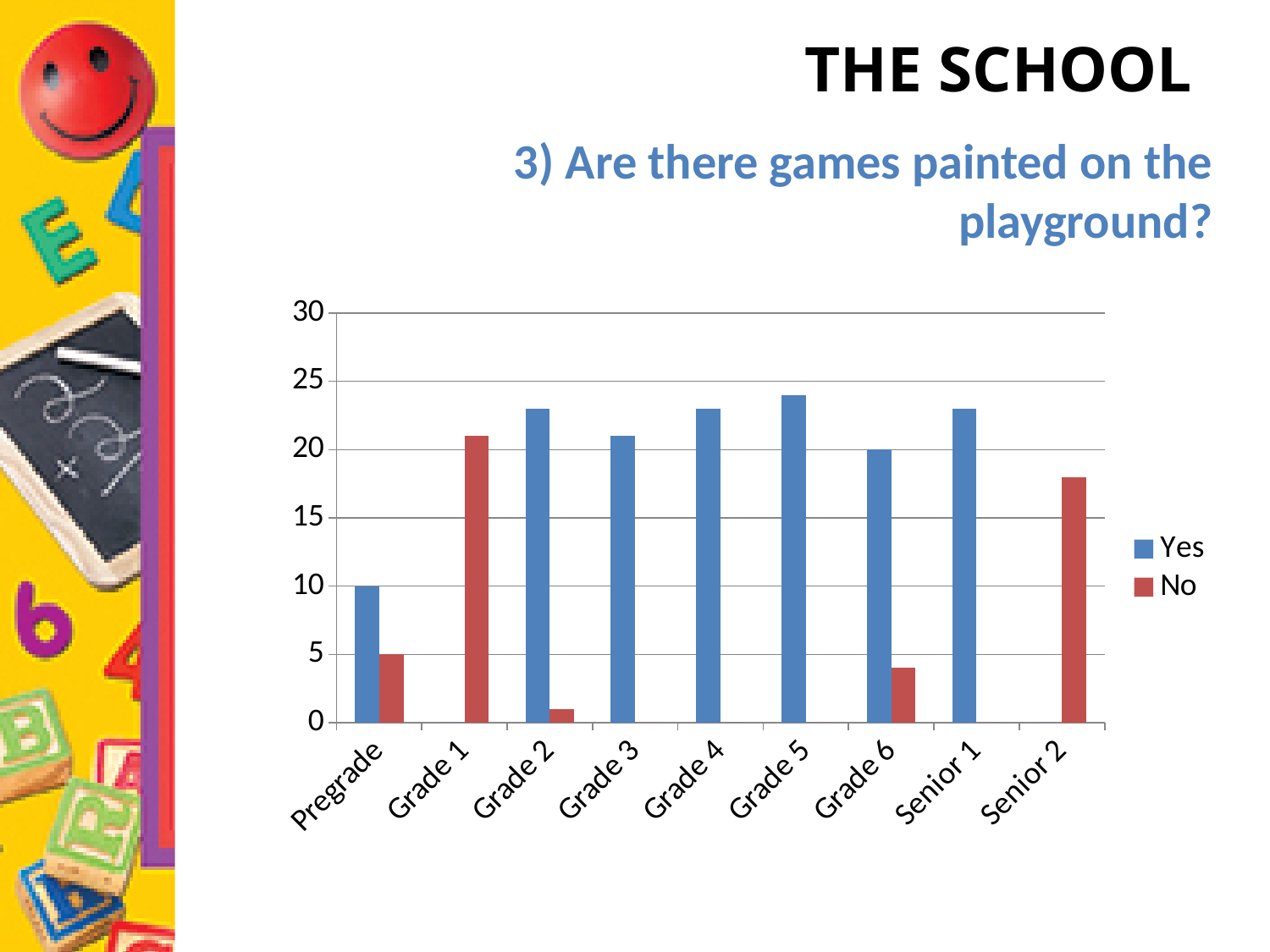
What is the value of the Yes bar for Grade 6? 20 For Pregrade, which is larger, the Yes bar or the No bar? Yes What is the value of the Yes bar for Pregrade? 10 Which category has the highest No bar? Grade 1 How many categories are shown on the x axis of the chart? 9 How many series does the chart's legend list? 2 Is the value of the No bar for Senior 2 greater or less than 15? greater Is the value of the Yes bar for Grade 2 greater or less than 20? greater Is the value of the No bar for Grade 6 greater or less than 5? less What is the value of the No bar for Pregrade? 5 Which colour represents the No series in the chart's legend? red What kind of chart is shown on the slide? bar chart